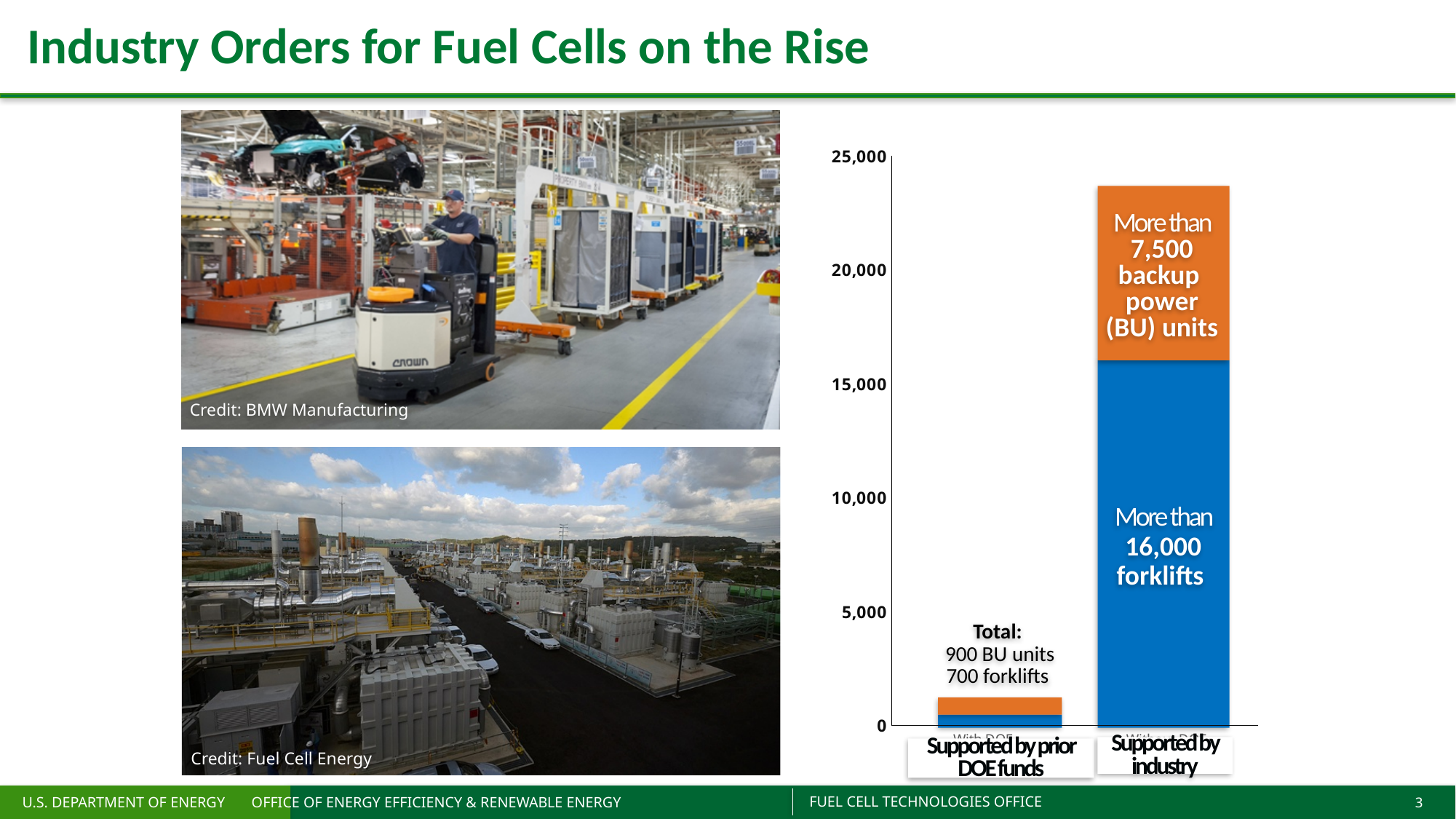
Which category has the taller bar, Supported by prior DOE funds or Supported by industry? Supported by industry Is the total height of the Supported by industry bar greater or less than 20,000? greater How many forklifts are shown for the Supported by prior DOE funds bar? 700 forklifts Which category has the shorter bar in the chart? Supported by prior DOE funds How many categories (bars) does the chart show? 2 How many BU units are shown for the Supported by prior DOE funds bar? 900 BU units Is the forklifts segment of the Supported by industry bar greater or less than 10,000? greater What does the label on the blue segment of the Supported by industry bar say? More than 16,000 forklifts What does the label on the orange segment of the Supported by industry bar say? More than 7,500 backup power (BU) units Which colour represents forklifts in the stacked bars? blue What is the combined total of BU units and forklifts for the Supported by prior DOE funds bar? 1,600 What kind of chart is shown on the right side of the slide? bar chart